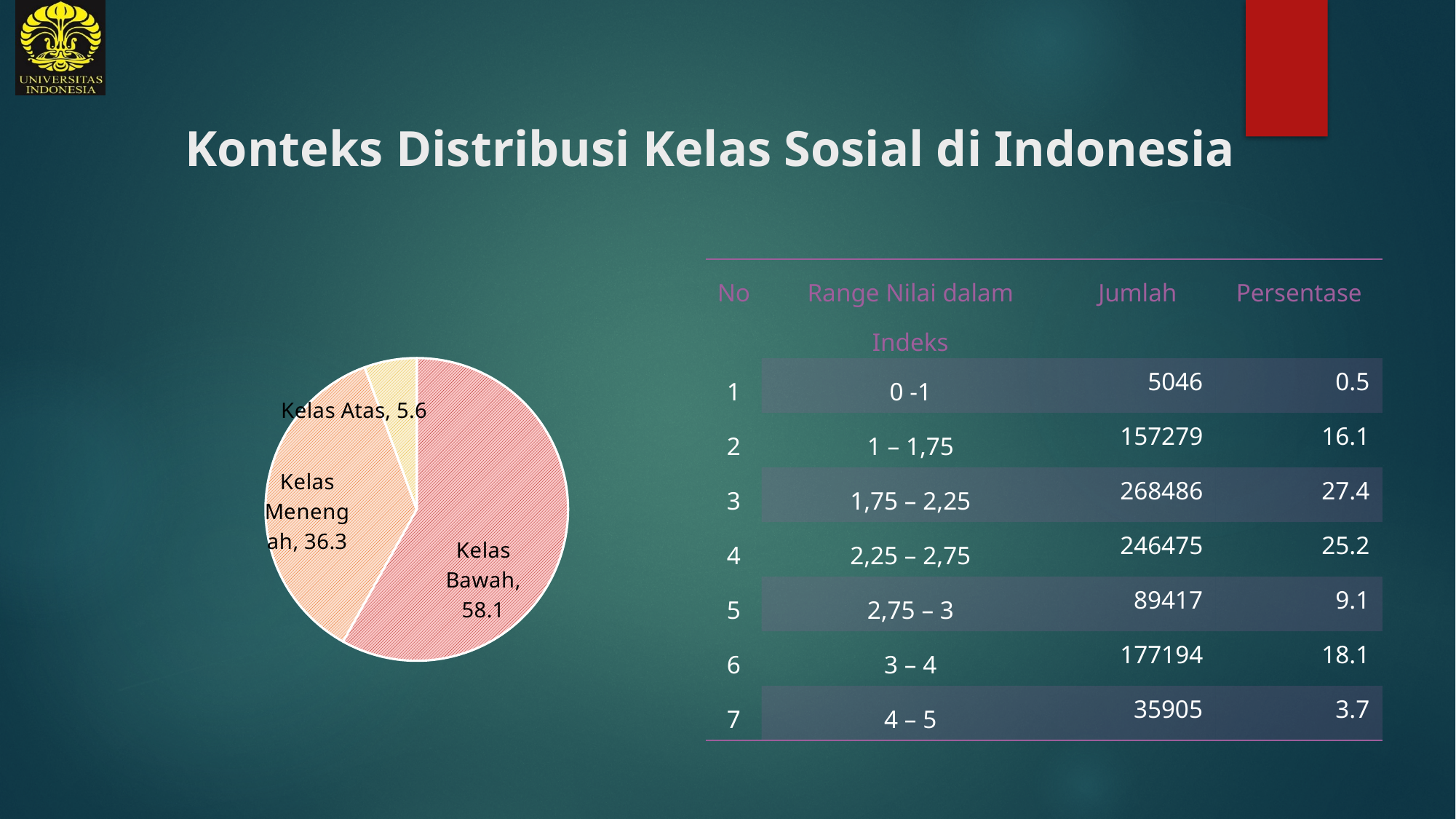
What is the value shown for Kelas Atas in the pie chart? 5.6 What is the difference between the values for Kelas Menengah and Kelas Atas in the pie chart? 30.7 Which is larger in the pie chart, Kelas Menengah or Kelas Atas? Kelas Menengah What is the value shown for Kelas Menengah in the pie chart? 36.3 Which category has the largest slice in the pie chart? Kelas Bawah What is the value shown for Kelas Bawah in the pie chart? 58.1 What type of chart is shown on the slide? pie chart What share of the pie does the Kelas Bawah slice represent? 58.1 Which category has the smallest slice in the pie chart? Kelas Atas How many slices does the pie chart have? 3 What is the difference between the values for Kelas Bawah and Kelas Menengah in the pie chart? 21.8 Which slice of the pie chart is coloured yellow? Kelas Atas